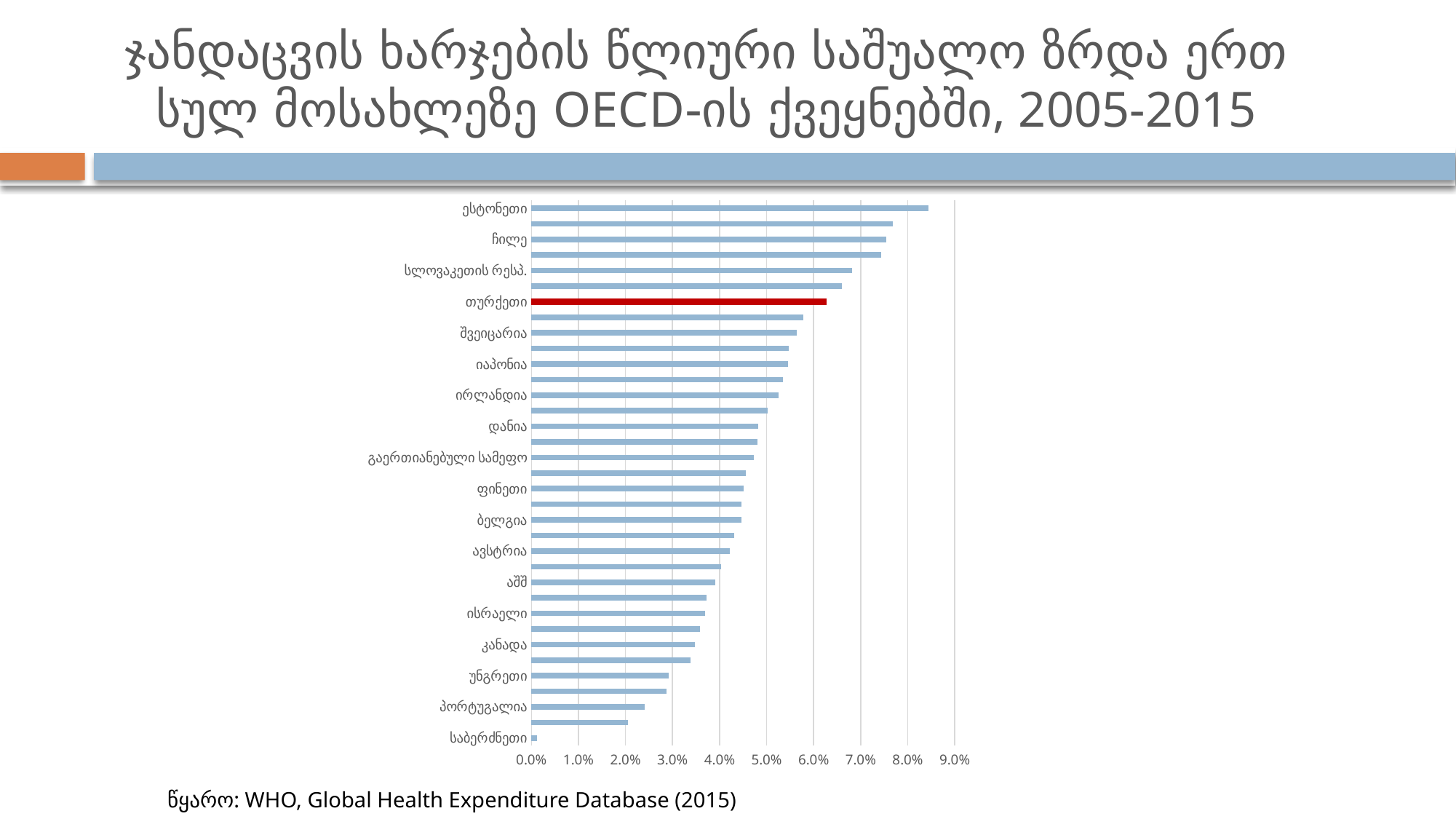
Is the value for თურქეთი greater or less than 6.0%? greater Is the value for კანადა greater or less than 4.0%? less What kind of chart is shown on the slide? bar chart Which country's bar is highlighted in red? თურქეთი Is the value for პორტუგალია greater or less than 3.0%? less Which country has the lowest value in the chart? საბერძნეთი Which has the larger value, ჩილე or თურქეთი? ჩილე Do the bar values increase or decrease going from the top of the chart to the bottom? decrease Which country has the highest value in the chart? ესტონეთი